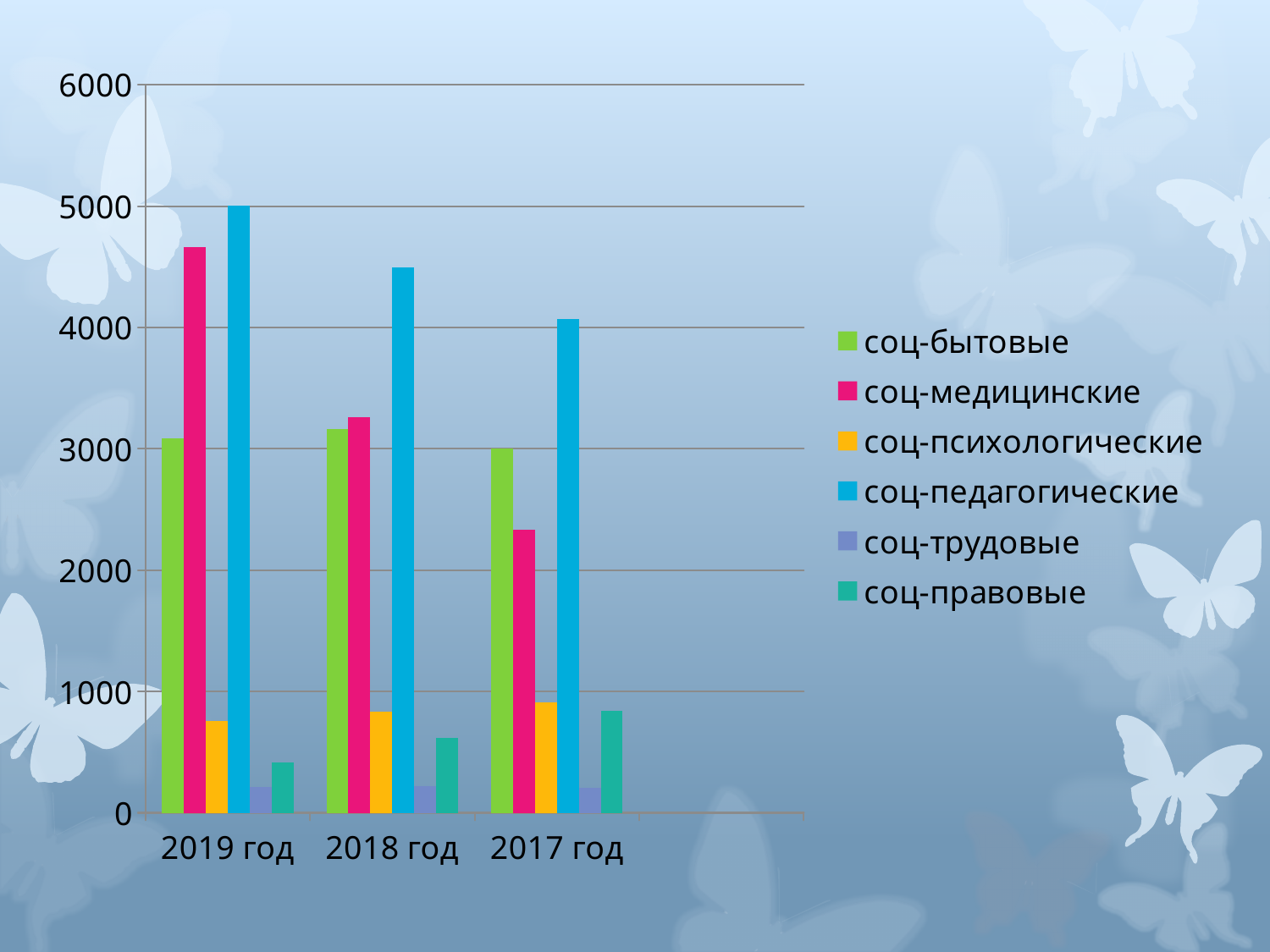
What kind of chart is shown on the slide? bar chart What colour are the bars for соц-бытовые? green Which series has the lowest bar in 2018 год? соц-трудовые Is the value for соц-медицинские in 2019 год greater or less than 4000? greater Does the соц-педагогические series rise or fall moving from 2019 год to 2017 год along the x axis? fall Which series has the highest bar in 2019 год? соц-педагогические Is the value for соц-психологические in 2018 год greater or less than 1000? less Which is larger in 2017 год: соц-бытовые or соц-медицинские? соц-бытовые How many series does the legend list? 6 Is the value for соц-педагогические in 2017 год greater or less than 4000? greater Which is larger in 2019 год: соц-правовые or соц-психологические? соц-психологические How many year categories are shown on the x axis? 3